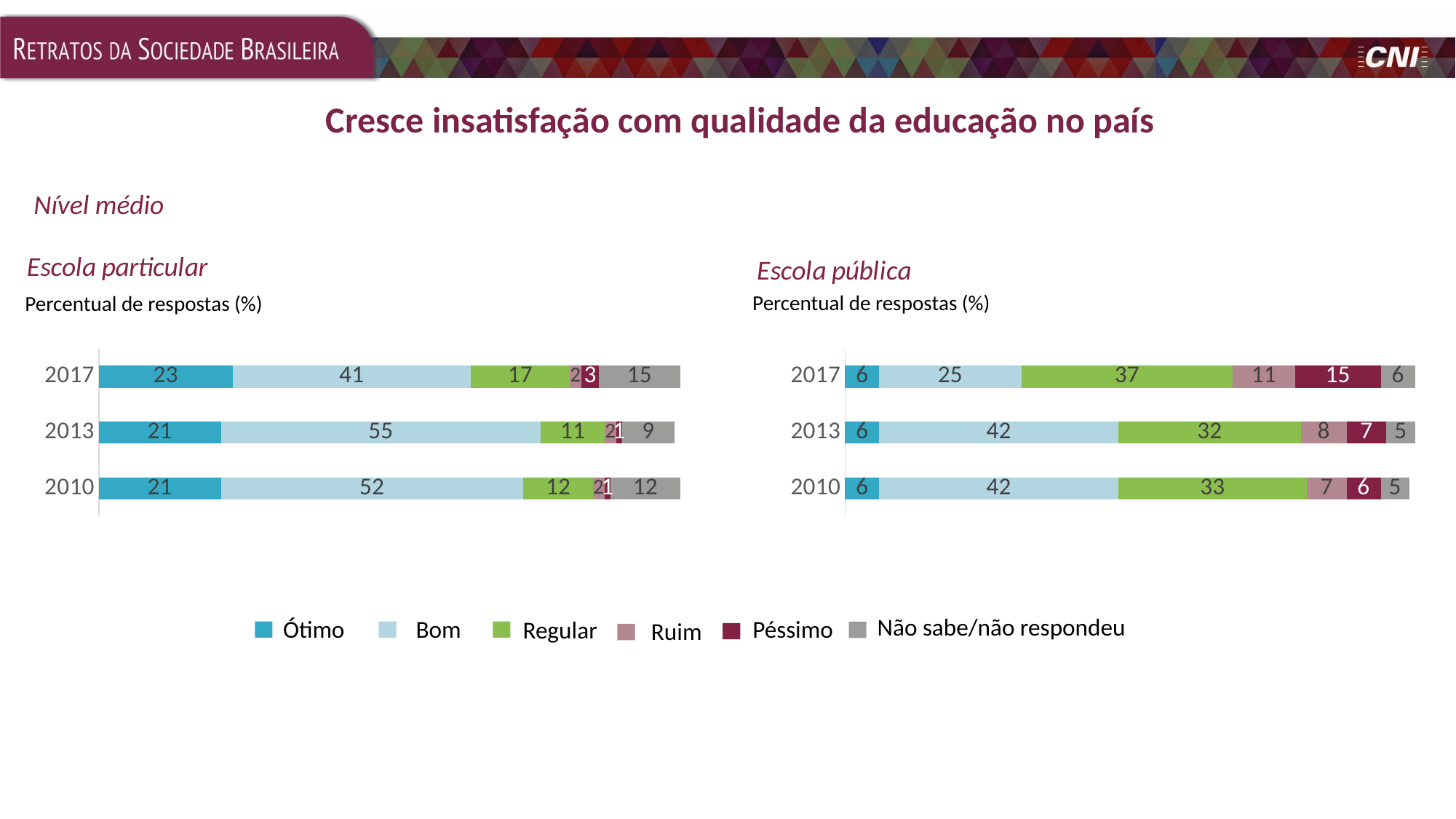
In the Escola particular chart, what is the value for Bom in 2013? 55 In the Escola pública chart, what is the difference between the Bom value in 2013 and in 2017? 17 How many years are shown in the Escola pública chart? 3 In the Escola particular chart, is the Regular value larger in 2017 or in 2010? 2017 What kind of chart is the Escola particular chart? Stacked bar chart In the Escola pública chart, which year has the highest value for Péssimo? 2017 In the Escola particular chart, what is the value for Não sabe/não respondeu in 2017? 15 In the Escola pública chart, what is the value for Regular in 2017? 37 How many series does the legend list? 6 In the Escola pública chart, what is the value for Péssimo in 2017? 15 In the Escola pública chart, what is the total of the 2013 bar? 100 In the Escola particular chart, which year has the lowest value for Bom? 2017